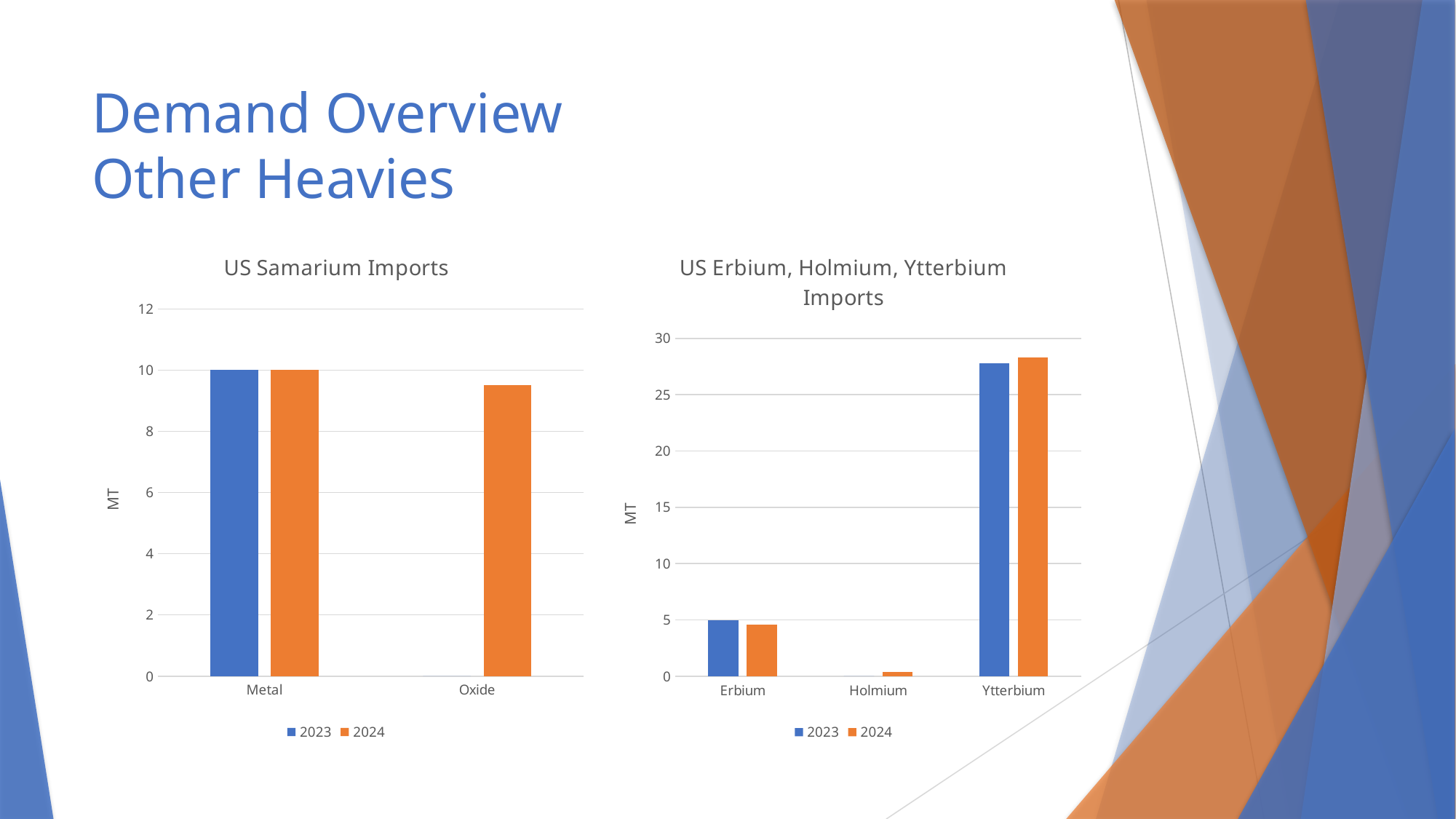
In the US Erbium, Holmium, Ytterbium Imports chart, is the 2024 value for Ytterbium greater or less than 25? greater In the US Erbium, Holmium, Ytterbium Imports chart, what is the 2023 value for Erbium? 5 What kind of chart is the US Erbium, Holmium, Ytterbium Imports chart? Bar chart In the US Erbium, Holmium, Ytterbium Imports chart, which category has the highest 2024 value? Ytterbium In the US Samarium Imports chart, which category has the lower 2023 value? Oxide In the US Samarium Imports chart, what is the 2024 value for Metal? 10 In the US Samarium Imports chart, how many series does the legend list? 2 How many categories are shown on the x axis of the US Erbium, Holmium, Ytterbium Imports chart? 3 In the US Samarium Imports chart, what is the 2023 value for Metal? 10 In the US Erbium, Holmium, Ytterbium Imports chart, which is larger: the 2023 value for Erbium or the 2023 value for Ytterbium? Ytterbium In the US Samarium Imports chart, is the 2024 value for Oxide greater or less than 8? greater In the US Erbium, Holmium, Ytterbium Imports chart, is the 2024 value for Holmium greater or less than 5? less